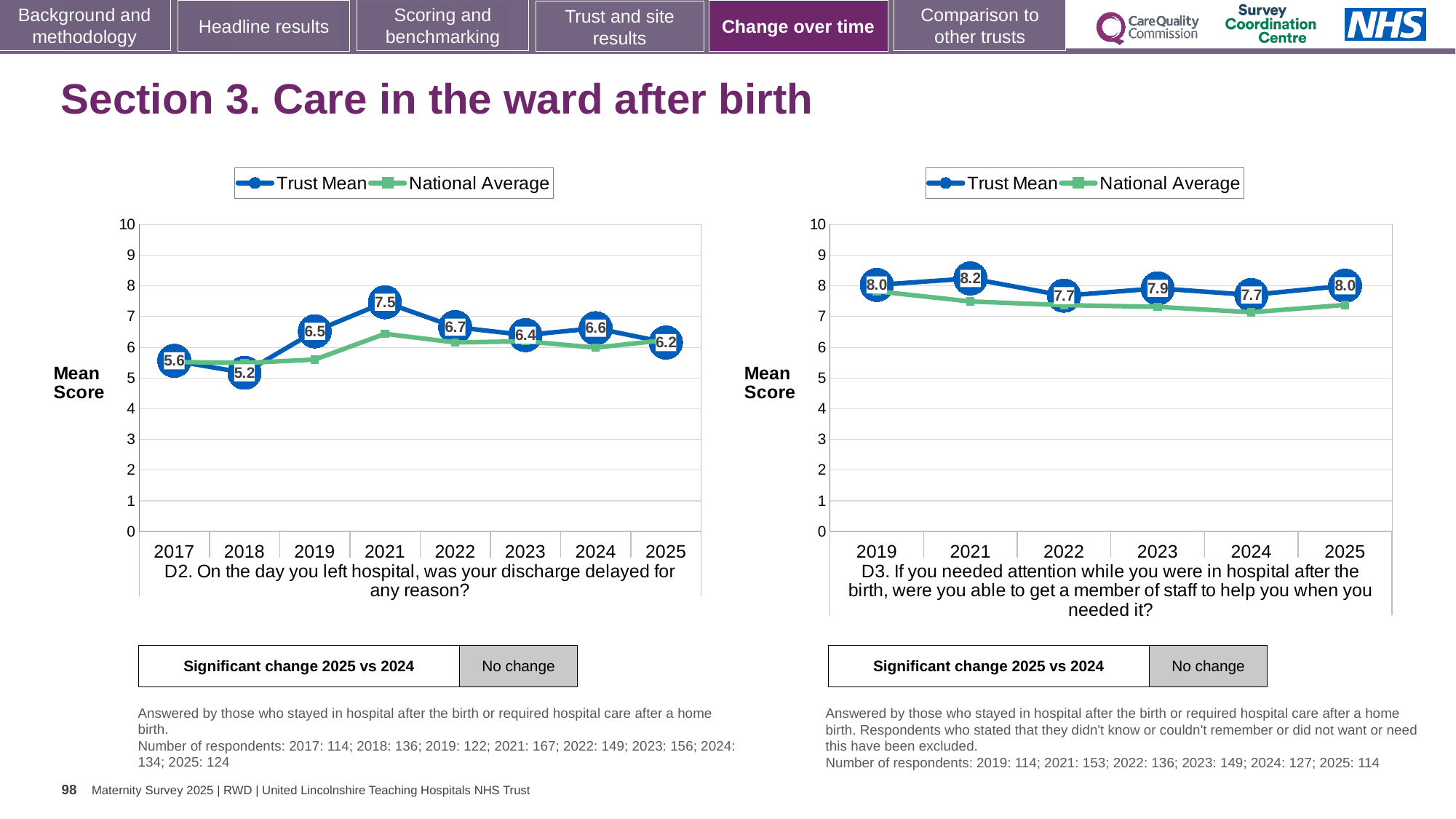
In the D2 chart (left), which year has the highest Trust Mean score? 2021 In the D3 chart (right), what is the Trust Mean score for 2021? 8.2 In the D2 chart (left), what is the difference between the Trust Mean scores for 2021 and 2025? 1.3 In the D2 chart (left), is the National Average value for 2017 greater or less than 7? less What kind of chart is the D3 chart (right)? Line chart In the D3 chart (right), is the National Average value for 2024 greater or less than 8? less In the D2 chart (left), how many years are shown on the x axis? 8 In the D2 chart (left), which year has the lowest Trust Mean score? 2018 In the D3 chart (right), how many series does the legend list? 2 In the D3 chart (right), which year has the highest Trust Mean score? 2021 In the D3 chart (right), is the Trust Mean score for 2022 larger or smaller than the score for 2023? smaller In the D2 chart (left), what is the Trust Mean score for 2021? 7.5